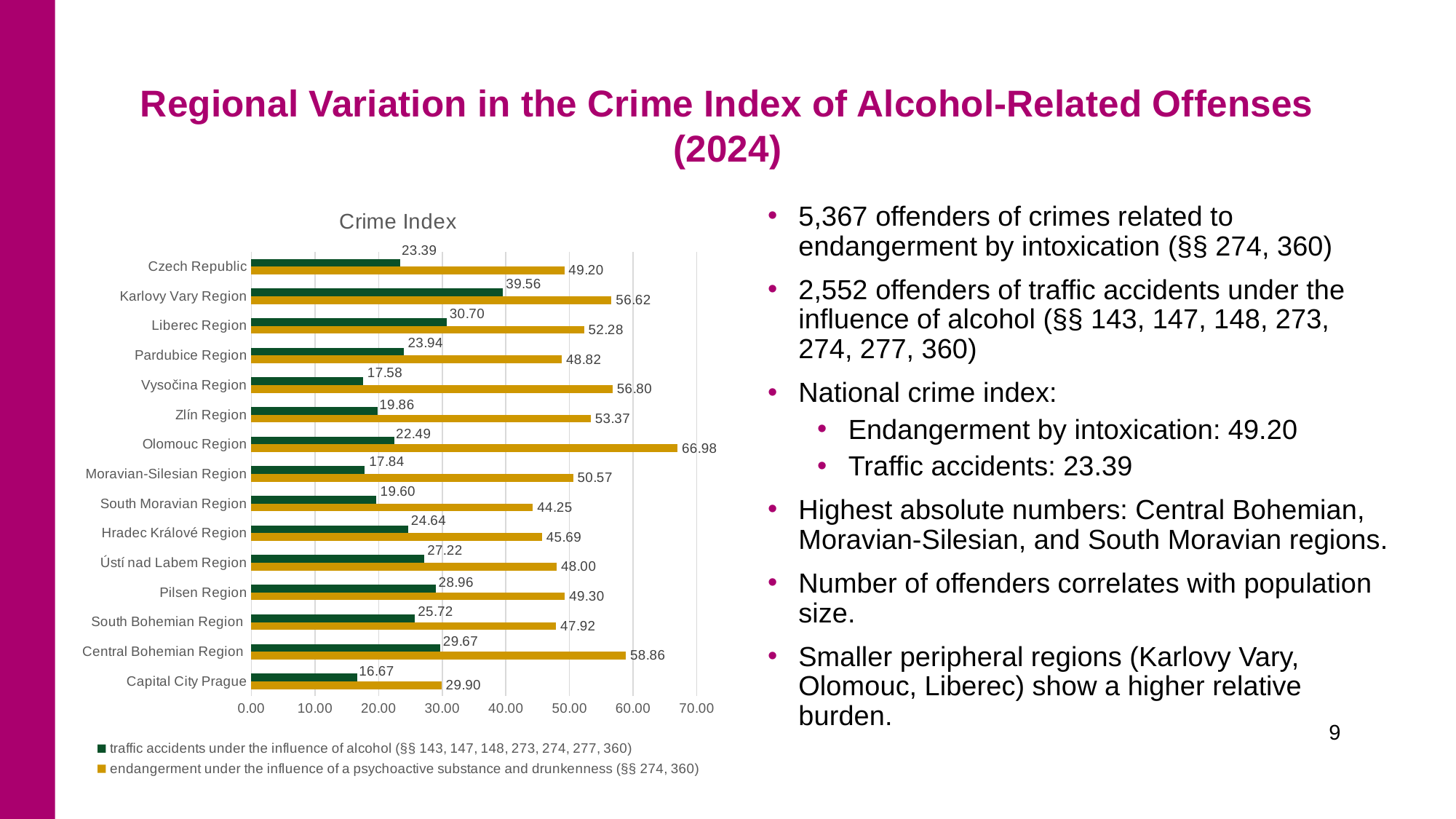
What is the title of the chart? Crime Index How many categories (regions including the Czech Republic) are shown on the chart? 15 What is the crime index for endangerment under the influence of a psychoactive substance and drunkenness in the Olomouc Region? 66.98 Which region has the highest crime index for traffic accidents under the influence of alcohol? Karlovy Vary Region Which is larger: the endangerment crime index for the Vysočina Region or for the Zlín Region? Vysočina Region Which region has the highest crime index for endangerment under the influence of a psychoactive substance and drunkenness? Olomouc Region What is the crime index for traffic accidents under the influence of alcohol in the Karlovy Vary Region? 39.56 How many series does the chart legend list? 2 What is the crime index for endangerment under the influence of a psychoactive substance and drunkenness for the Czech Republic? 49.20 What is the difference between the endangerment and traffic accidents crime index values for the Olomouc Region? 44.49 What type of chart is shown on the slide? bar chart Which category has the lowest crime index for traffic accidents under the influence of alcohol? Capital City Prague